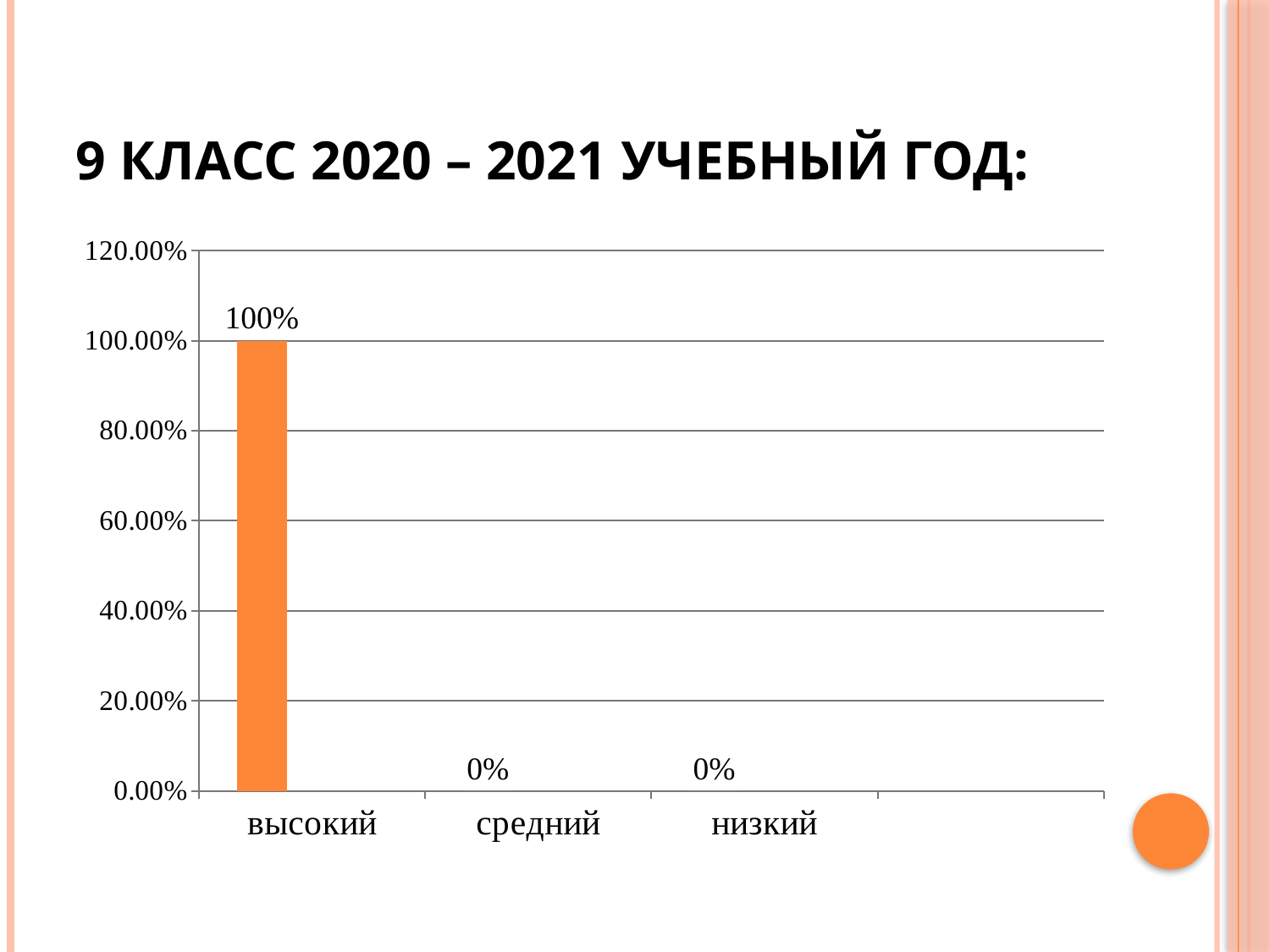
Which is larger, the value for высокий or the value for низкий? высокий What is the value for средний? 0% What is the value for высокий? 100% What is the value for низкий? 0% Which category has the highest value? высокий What colour is the bar for высокий? orange What is the difference between the values for высокий and средний? 100% How many categories are shown on the x axis? 3 What is the title of the slide above the chart? 9 КЛАСС 2020 – 2021 УЧЕБНЫЙ ГОД: Is the value for высокий greater or less than 80.00%? greater What kind of chart is shown on the slide? bar chart Do the values rise or fall from высокий to низкий along the x axis? fall